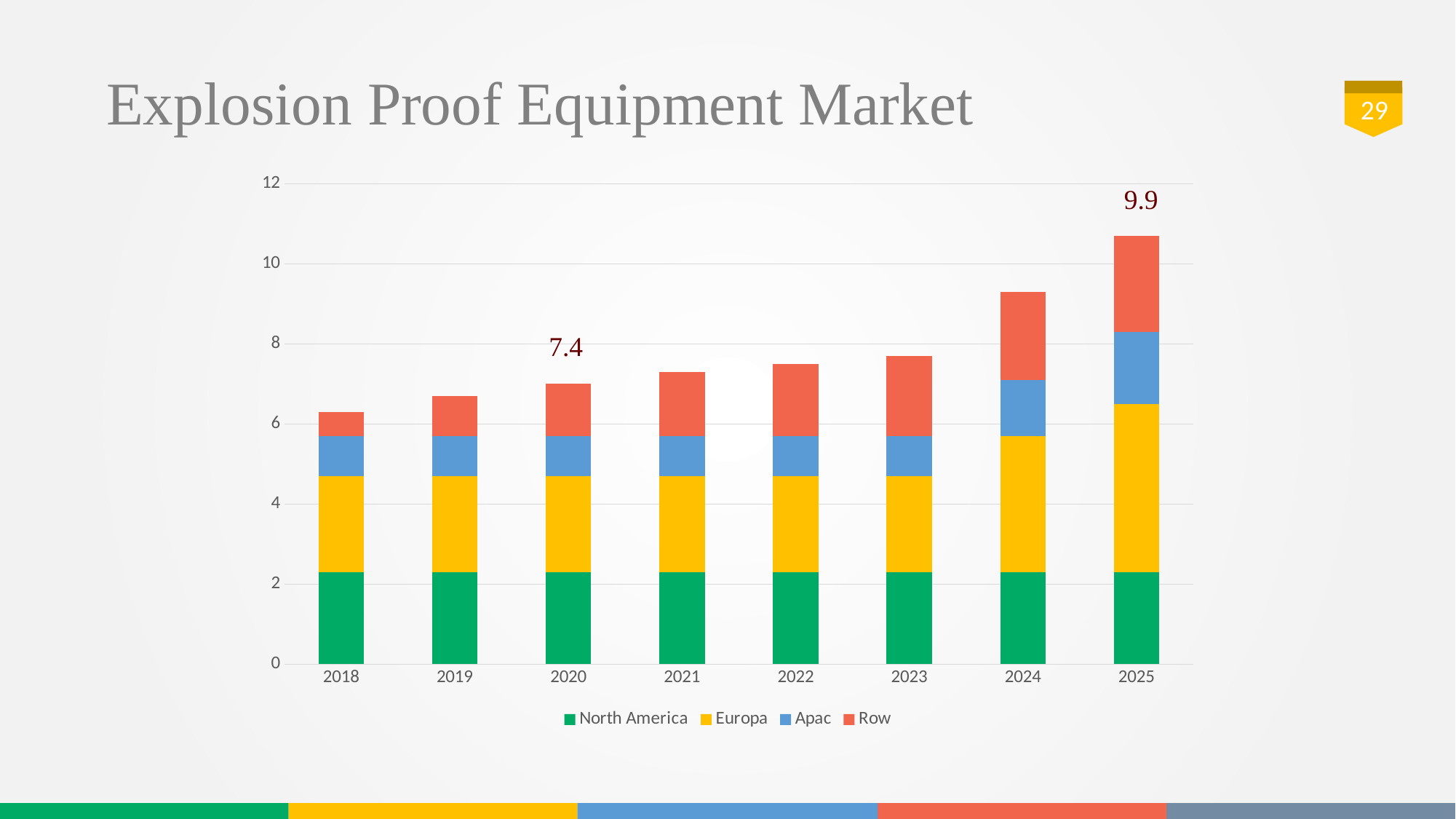
Is the total stacked bar for 2025 greater or less than 10? greater Which year has the taller stacked bar, 2023 or 2024? 2024 Is the total stacked bar for 2021 greater or less than 8? less Is the total stacked bar for 2024 greater or less than 10? less Which year has the tallest stacked bar? 2025 What kind of chart is shown on the slide? stacked bar chart Which year has the shortest stacked bar? 2018 Which series is shown in blue in the legend? Apac How many series does the chart legend list? 4 Do the total stacked bar heights rise or fall from 2018 to 2025? rise How many years are shown on the x axis of the chart? 8 What number is annotated above the 2025 bar? 9.9